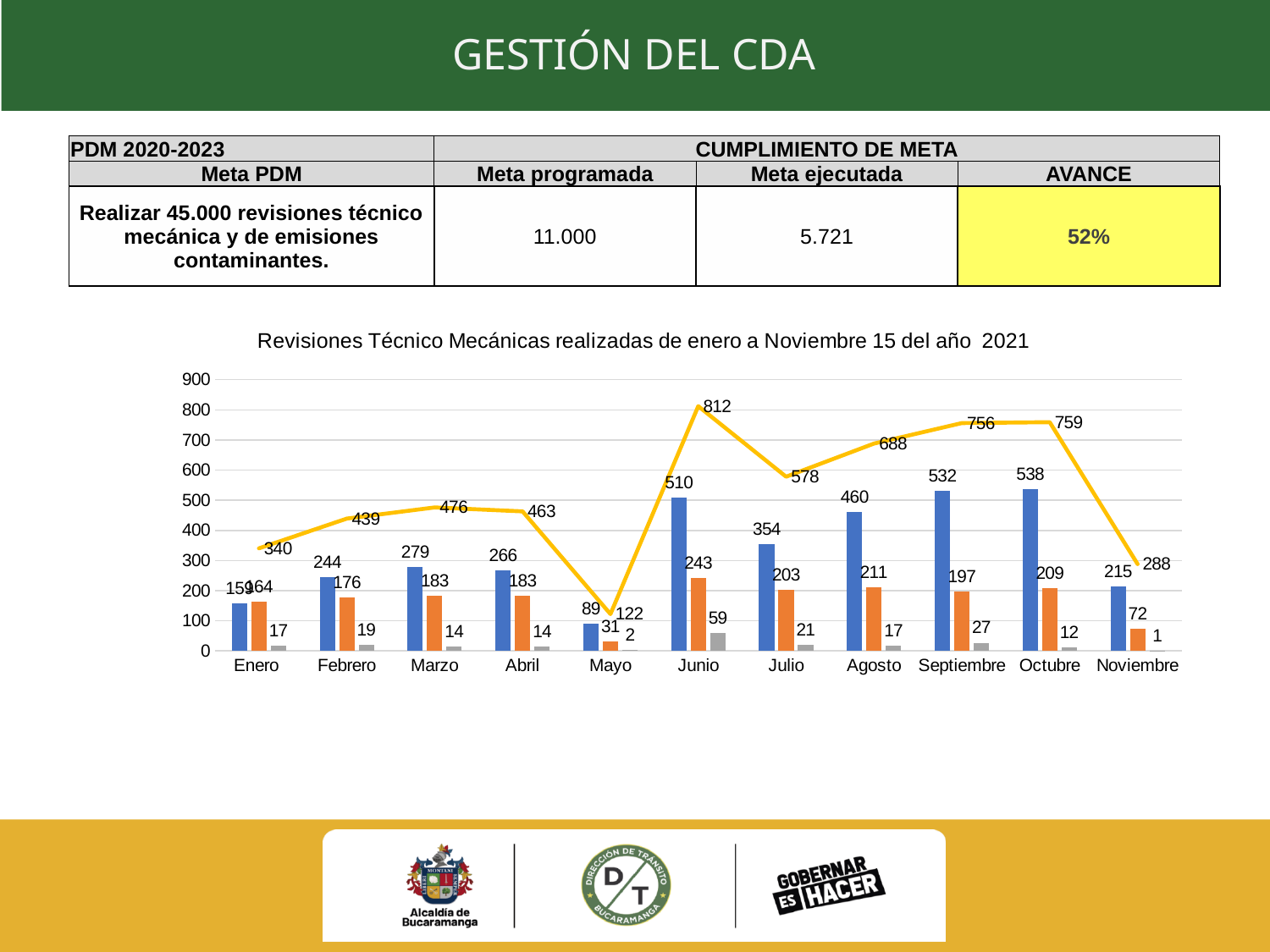
What is the value of the blue bar for Octubre? 538 What is the value of the gray bar for Junio? 59 How many months are shown on the x axis? 11 In which month does the yellow line reach its highest value? Junio What is the value of the yellow line for Junio? 812 In which month is the blue bar lowest? Mayo What is the difference between the blue bar values for Octubre and Septiembre? 6 What is the value of the orange bar for Mayo? 31 What kind of chart is shown on the slide? Combined bar and line chart Which is larger, the yellow line value for Septiembre or for Octubre? Octubre Does the yellow line rise or fall from Octubre to Noviembre? Fall What is the title of the chart? Revisiones Técnico Mecánicas realizadas de enero a Noviembre 15 del año 2021